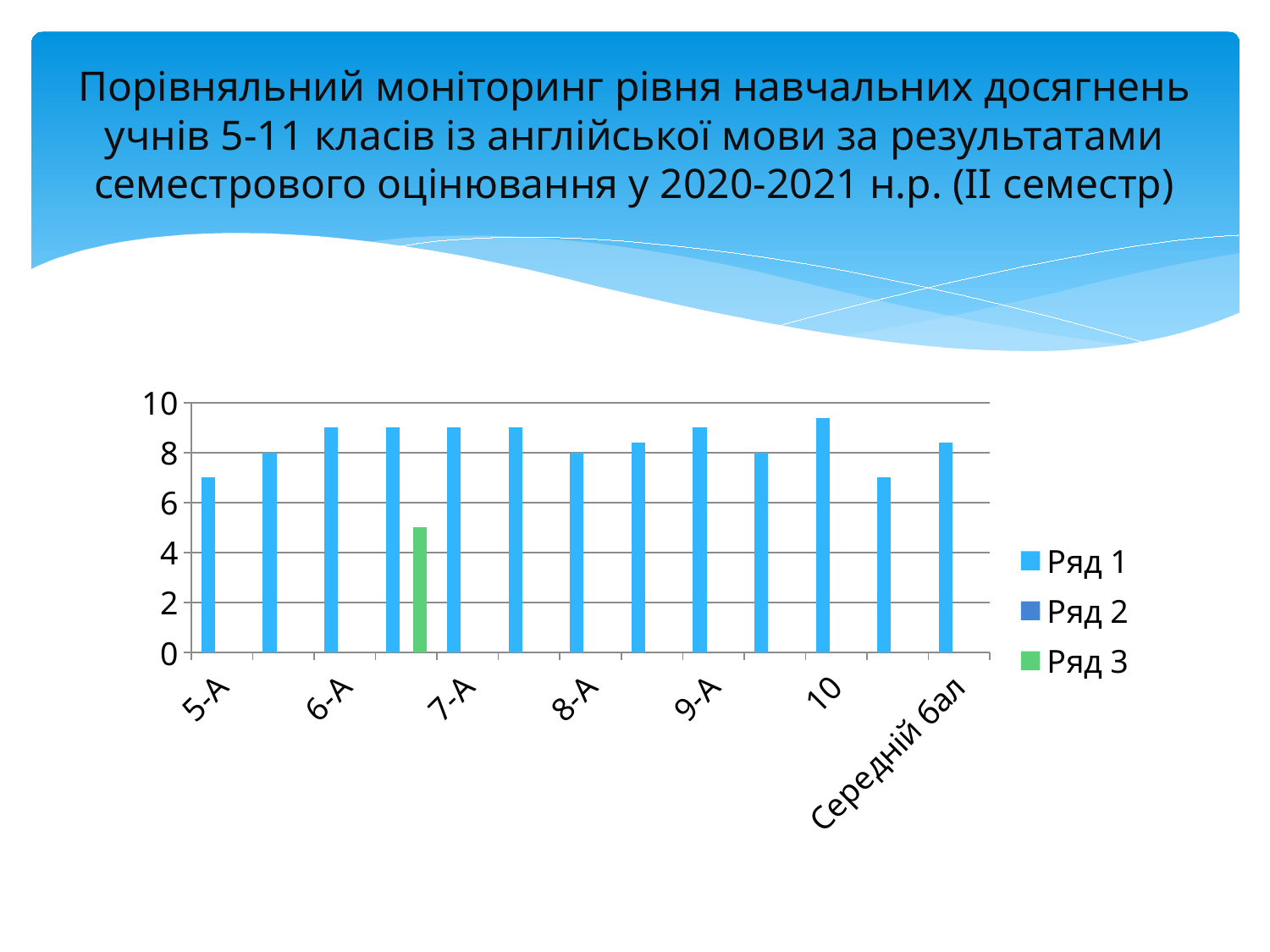
Is the Ряд 1 value for 5-А greater or less than 8? less What is the value of the Ряд 1 bar for 8-А? 8 Is the Ряд 1 value for 6-А greater or less than 8? greater What are the legend entries of the chart? Ряд 1, Ряд 2, Ряд 3 Which has the larger Ряд 1 value, 5-А or 6-А? 6-А How many series does the legend list? 3 How many category labels are shown on the x axis? 7 Is the Ряд 1 value for 9-А greater or less than 8? greater What colour is the Ряд 3 series in the legend? green Which has the larger Ряд 1 value, 8-А or 9-А? 9-А What type of chart is shown on the slide? bar chart